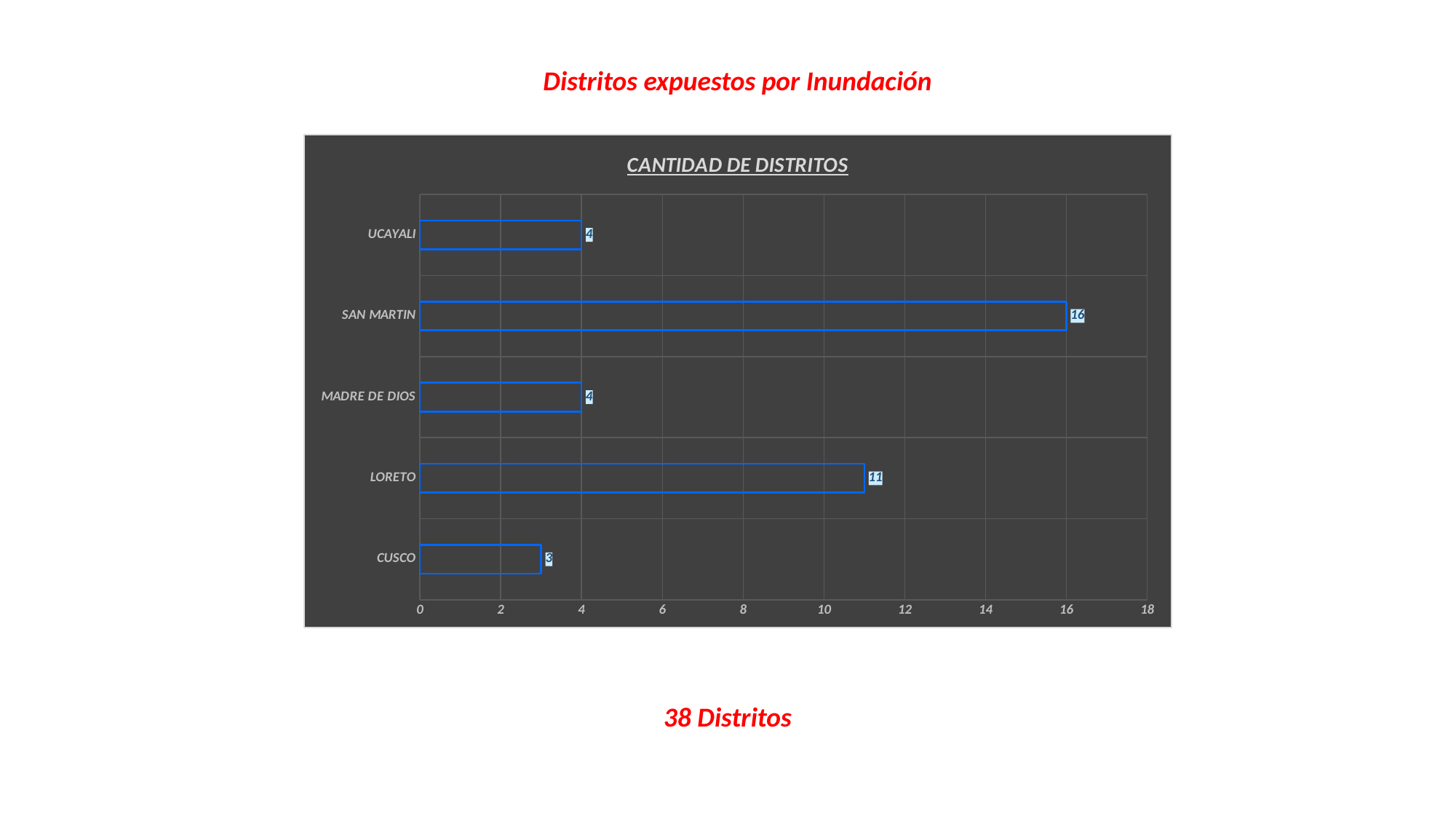
Which is larger, the value for LORETO or the value for MADRE DE DIOS? LORETO What is the value for SAN MARTIN? 16 How many categories are shown in the chart? 5 What is the value for UCAYALI? 4 Which category has the highest value? SAN MARTIN What kind of chart is shown? bar chart What is the value for CUSCO? 3 What is the title of the chart? CANTIDAD DE DISTRITOS What is the difference between the values for SAN MARTIN and LORETO? 5 What is the value for LORETO? 11 Is the value for SAN MARTIN greater or less than 14? greater Which category has the lowest value? CUSCO